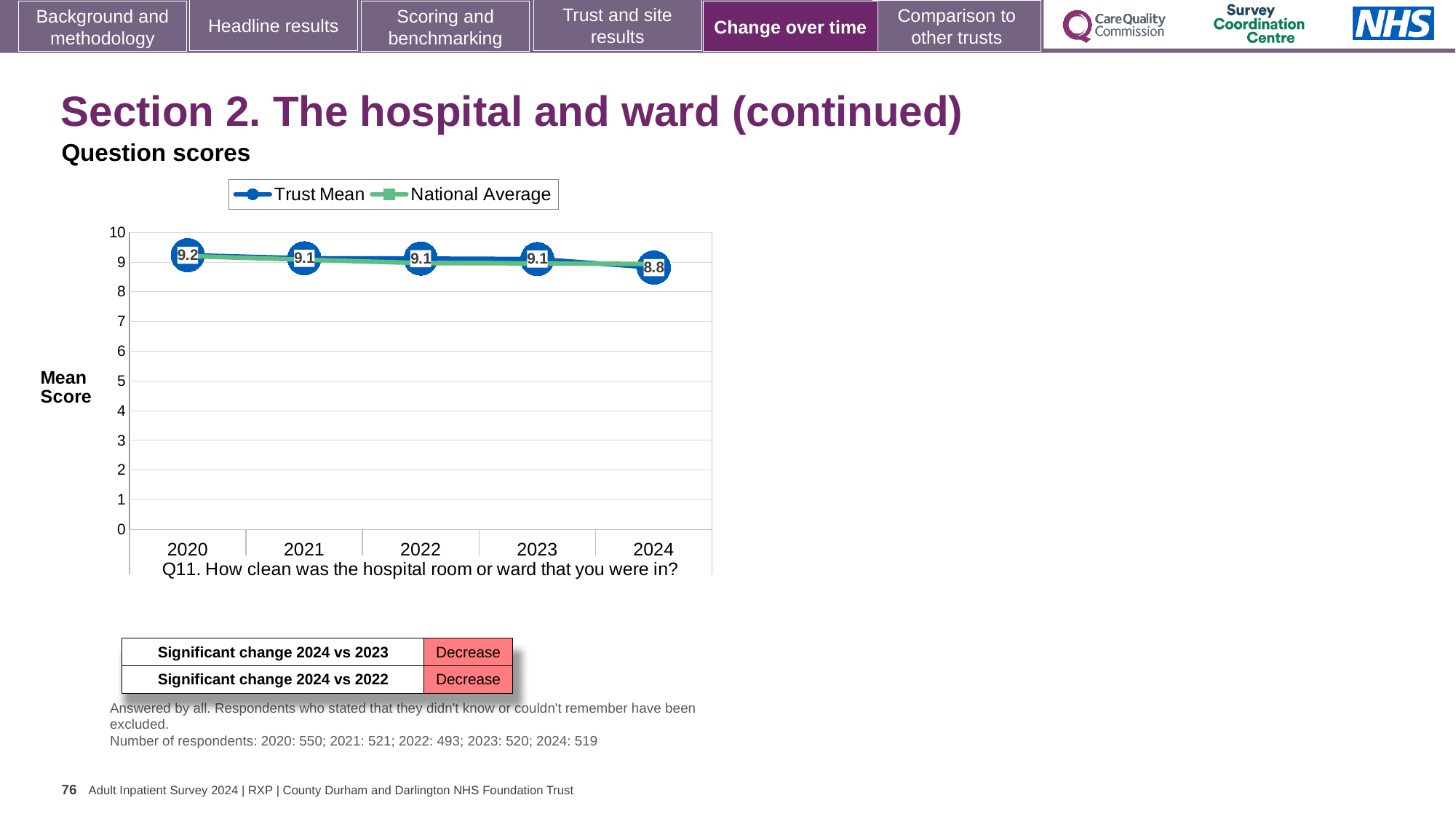
Which year has the lowest Trust Mean? 2024 Does the Trust Mean rise or fall from 2020 to 2024? fall What is the Trust Mean for 2024? 8.8 Which year has the highest Trust Mean? 2020 How many series does the legend list? 2 Which is larger, the Trust Mean for 2023 or for 2024? 2023 What is the Trust Mean for 2022? 9.1 How many years are plotted on the x axis? 5 Is the National Average for 2024 greater or less than 8? greater What is the Trust Mean for 2020? 9.2 What kind of chart is shown? line chart What is the difference between the Trust Mean in 2020 and in 2024? 0.4